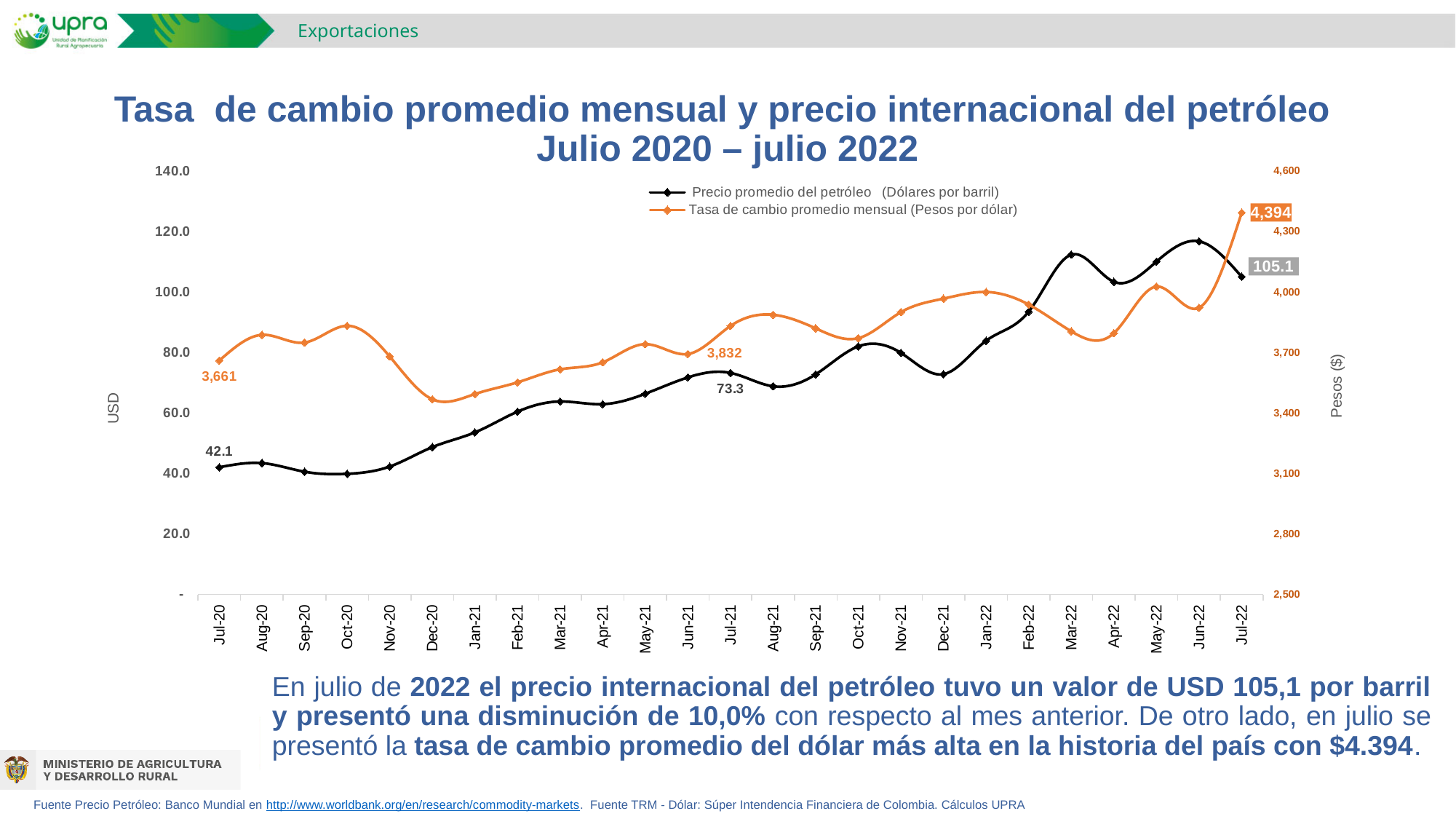
What was the monthly average exchange rate (Tasa de cambio promedio mensual) in Jul-20? 3,661 Is the average oil price in Jun-22 greater or less than 100.0? greater What type of chart is shown on the slide? line chart By how much did the average oil price increase between Jul-20 and Jul-22? 63.0 What was the average oil price (Precio promedio del petróleo) in Jul-22? 105.1 By how much did the monthly average exchange rate increase between Jul-21 and Jul-22? 562 Which month has the highest value for the Tasa de cambio promedio mensual series? Jul-22 How many months are plotted on the x axis? 25 How many series does the chart legend list? 2 What was the average oil price (Precio promedio del petróleo) in Jul-21? 73.3 What was the monthly average exchange rate (Tasa de cambio promedio mensual) in Jul-22? 4,394 What was the average oil price (Precio promedio del petróleo) in Jul-20? 42.1